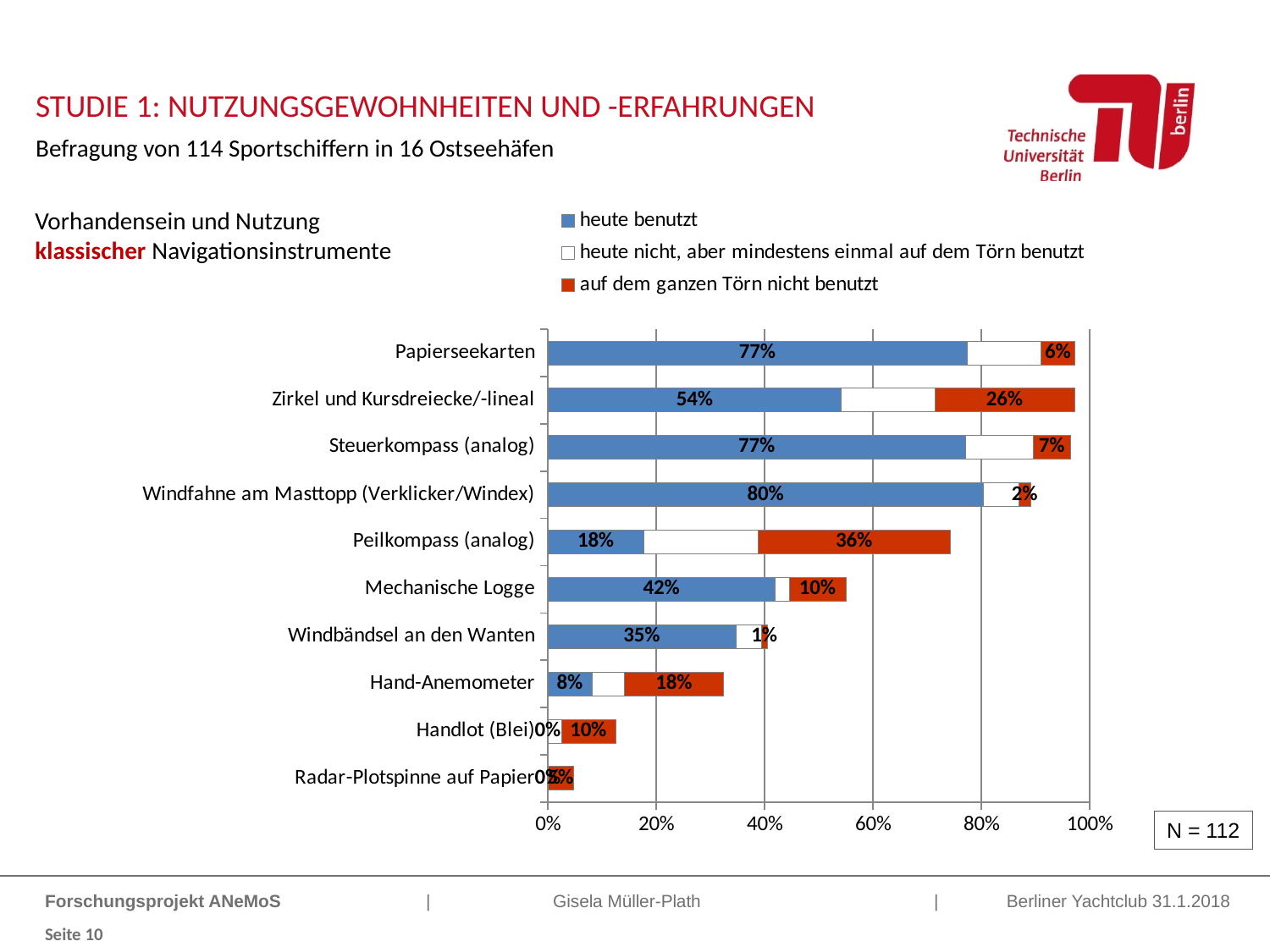
How many series does the legend list? 3 What is the "heute benutzt" value for Handlot (Blei)? 0% What is the "auf dem ganzen Törn nicht benutzt" value for Zirkel und Kursdreiecke/-lineal? 26% Which instrument has the highest "heute benutzt" value? Windfahne am Masttopp (Verklicker/Windex) How many navigation instruments (categories) are shown in the chart? 10 What is the difference in "heute benutzt" between Papierseekarten and Zirkel und Kursdreiecke/-lineal? 23 percentage points Which instrument has the highest "auf dem ganzen Törn nicht benutzt" value? Peilkompass (analog) Is the total bar length for Peilkompass (analog) greater or less than 60%? greater What is the "heute benutzt" value for Papierseekarten? 77% What is the "heute benutzt" value for Hand-Anemometer? 8% What kind of chart is shown on the slide? bar chart Which has the larger "heute benutzt" value, Mechanische Logge or Windbändsel an den Wanten? Mechanische Logge